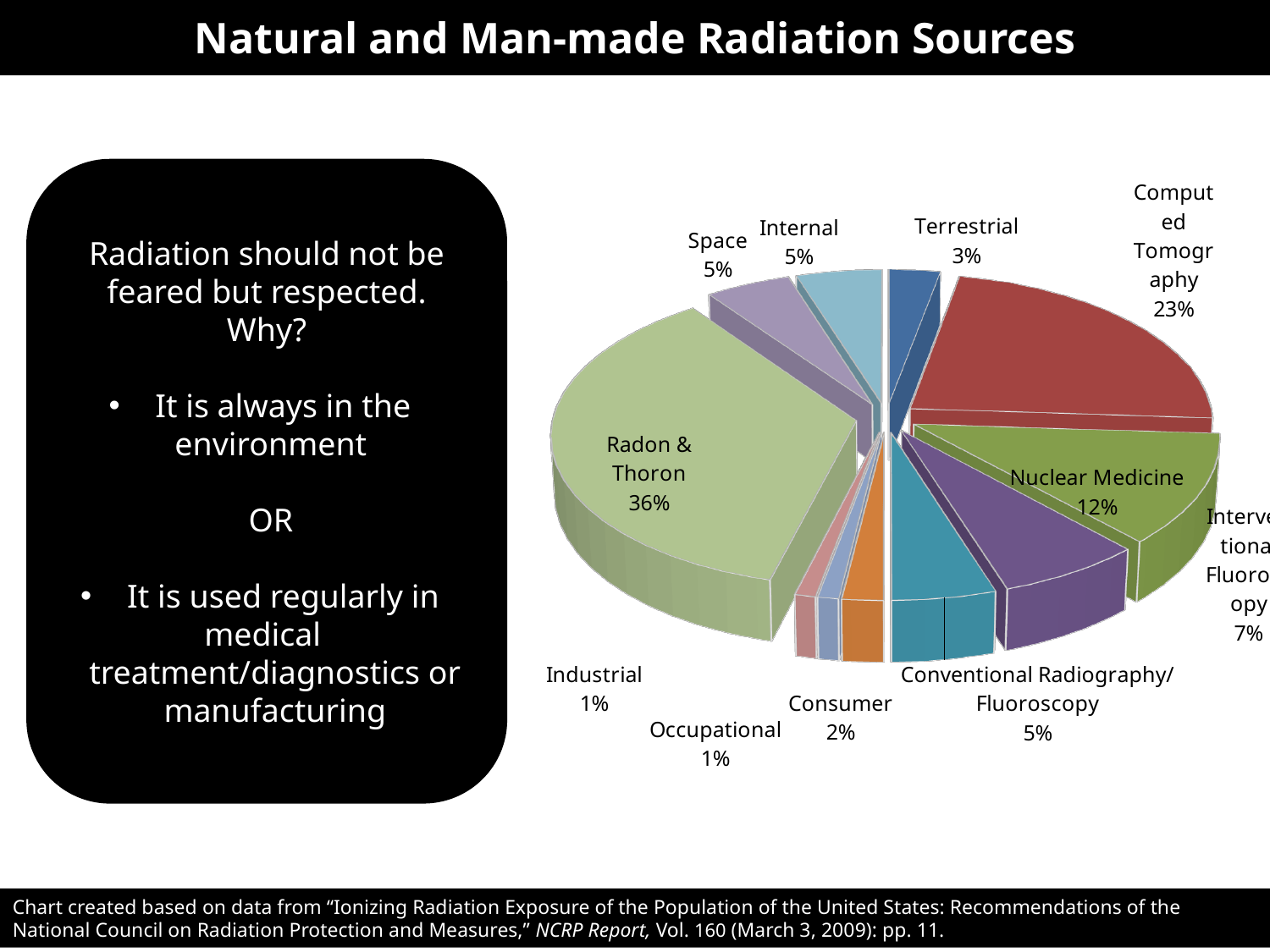
What is the value shown for Terrestrial? 3% What share of the pie does Radon & Thoron account for? 36% What is the title of the slide containing the chart? Natural and Man-made Radiation Sources What is the value shown for Nuclear Medicine? 12% What is the difference between the Nuclear Medicine share and the Terrestrial share? 9% What kind of chart is shown on the slide? pie chart How many slices does the pie chart have? 11 What is the difference between the Radon & Thoron share and the Computed Tomography share? 13% Which is larger, Nuclear Medicine or Conventional Radiography/Fluoroscopy? Nuclear Medicine What is the value shown for Computed Tomography? 23% Which category has the largest slice of the pie? Radon & Thoron What is the value shown for Consumer? 2%